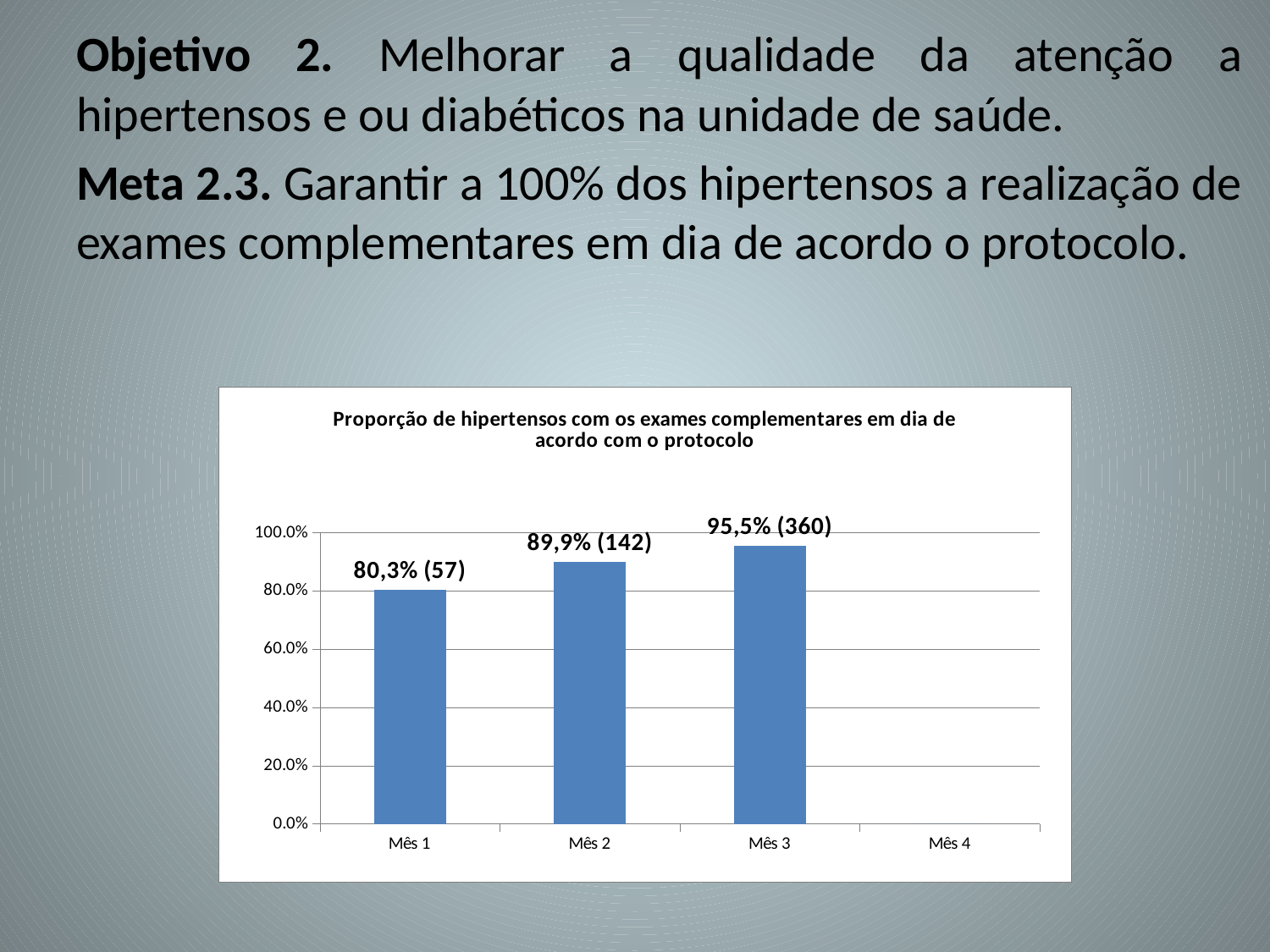
Among the months with a bar, which has the lowest proportion? Mês 1 What kind of chart is shown? Bar chart Is the value for Mês 3 greater or less than 100.0%? less Which month has the highest proportion? Mês 3 What is the value shown for Mês 3? 95,5% (360) Is the value for Mês 1 greater or less than 60.0%? greater Which is larger, the proportion for Mês 2 or for Mês 3? Mês 3 Do the values rise or fall from Mês 1 to Mês 3? Rise How many categories are shown on the x axis? 4 What is the title of the chart? Proporção de hipertensos com os exames complementares em dia de acordo com o protocolo What is the value shown for Mês 1? 80,3% (57) What is the value shown for Mês 2? 89,9% (142)